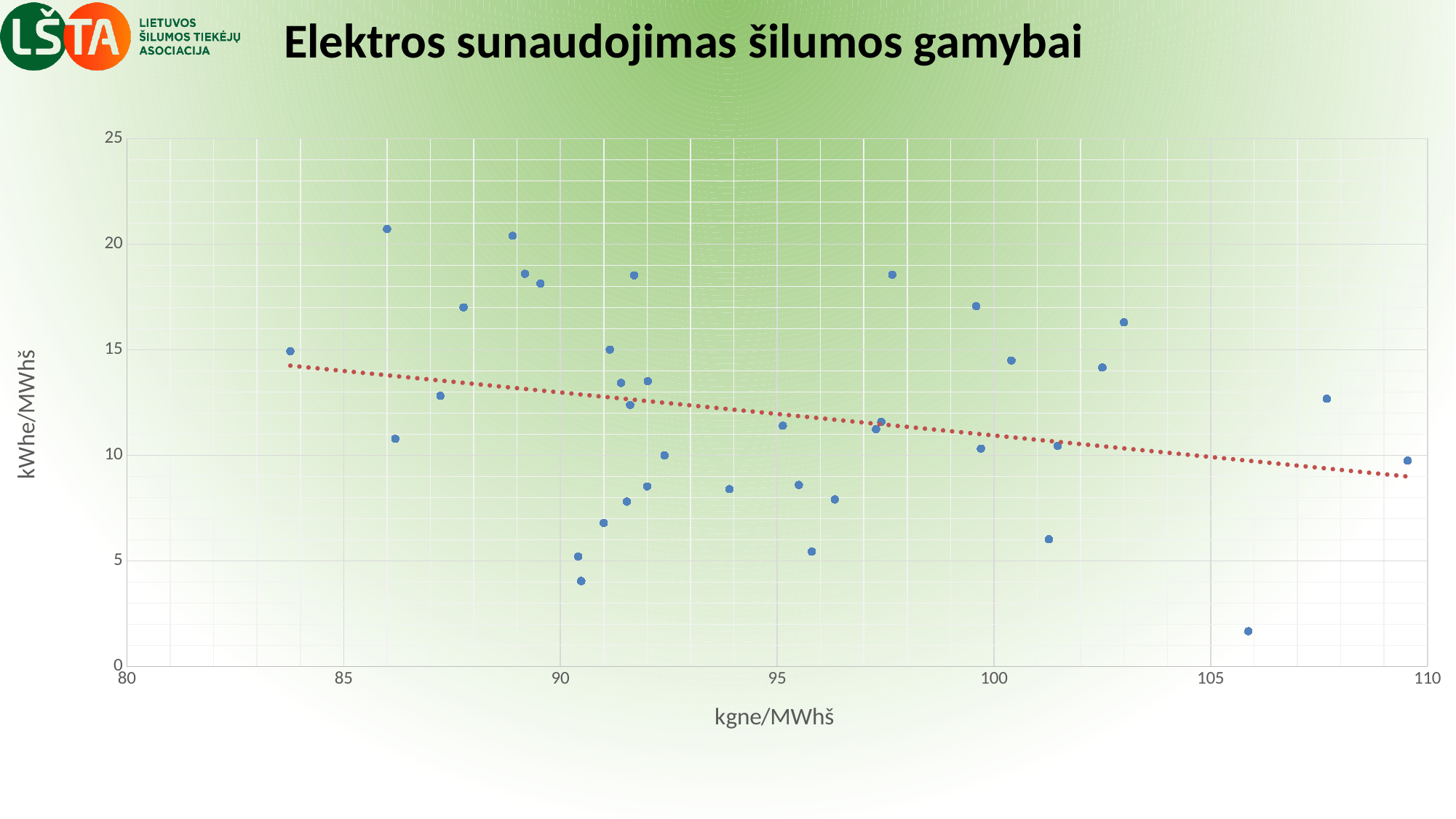
Is the x value of the rightmost point on the chart greater or less than 105? greater Is the y value of the trend line at x = 110 greater or less than 10? less What is the title of the chart? Elektros sunaudojimas šilumos gamybai What kind of chart is shown on the slide? scatter chart What is the label of the vertical axis? kWhe/MWhš Is the y value of the trend line at x = 85 greater or less than 10? greater Does the dotted trend line rise or fall as the x-axis value increases? fall